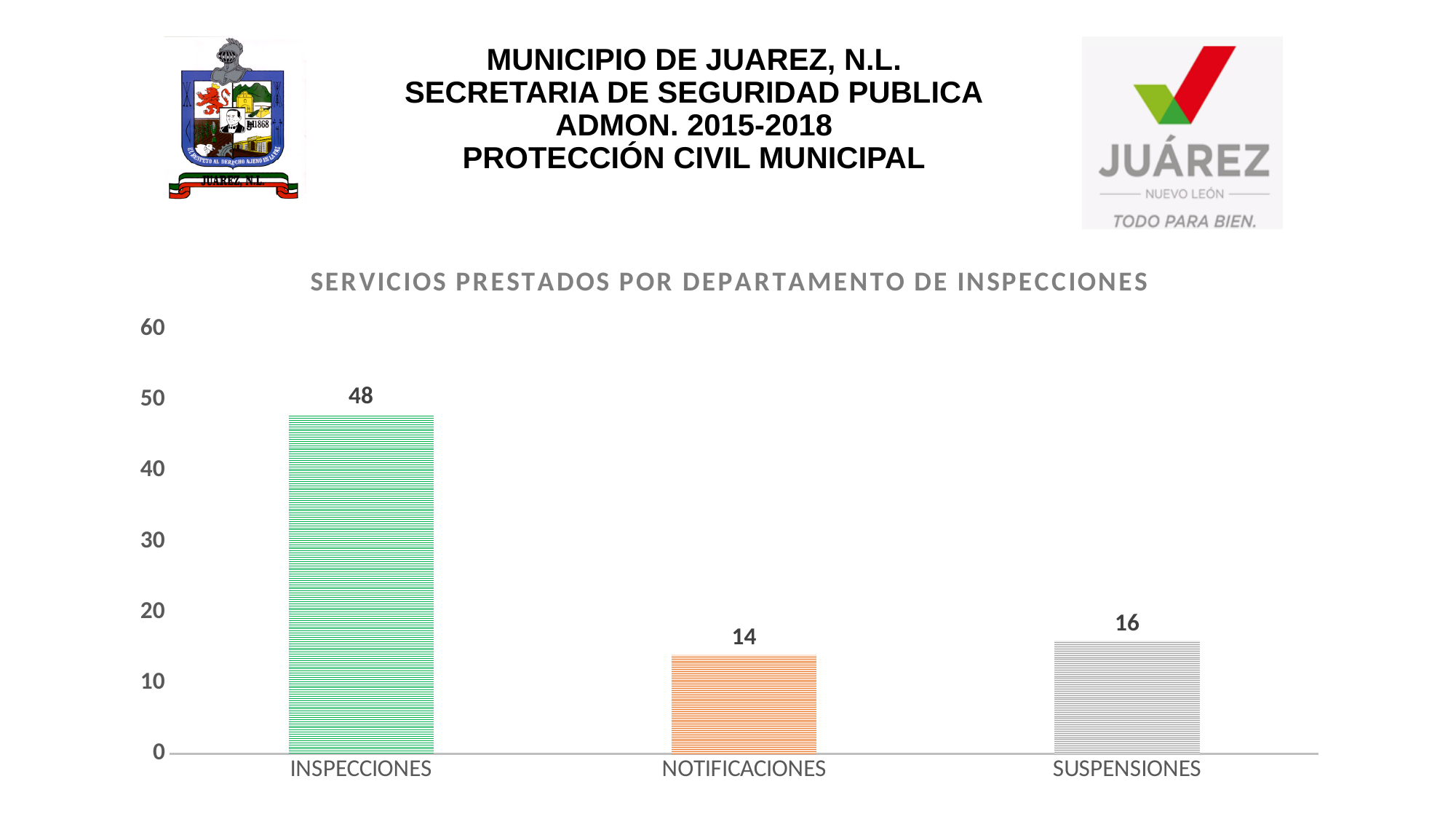
Which category has the lowest value? NOTIFICACIONES Is the value for INSPECCIONES greater or less than 40? greater Which category has the highest value? INSPECCIONES How many categories are shown in the chart? 3 What is the value for NOTIFICACIONES? 14 What is the value for INSPECCIONES? 48 Which is larger, the value for NOTIFICACIONES or the value for SUSPENSIONES? SUSPENSIONES What is the difference between the values for SUSPENSIONES and NOTIFICACIONES? 2 What kind of chart is shown on the slide? bar chart What is the difference between the values for INSPECCIONES and SUSPENSIONES? 32 What is the value for SUSPENSIONES? 16 What is the title of the chart? SERVICIOS PRESTADOS POR DEPARTAMENTO DE INSPECCIONES